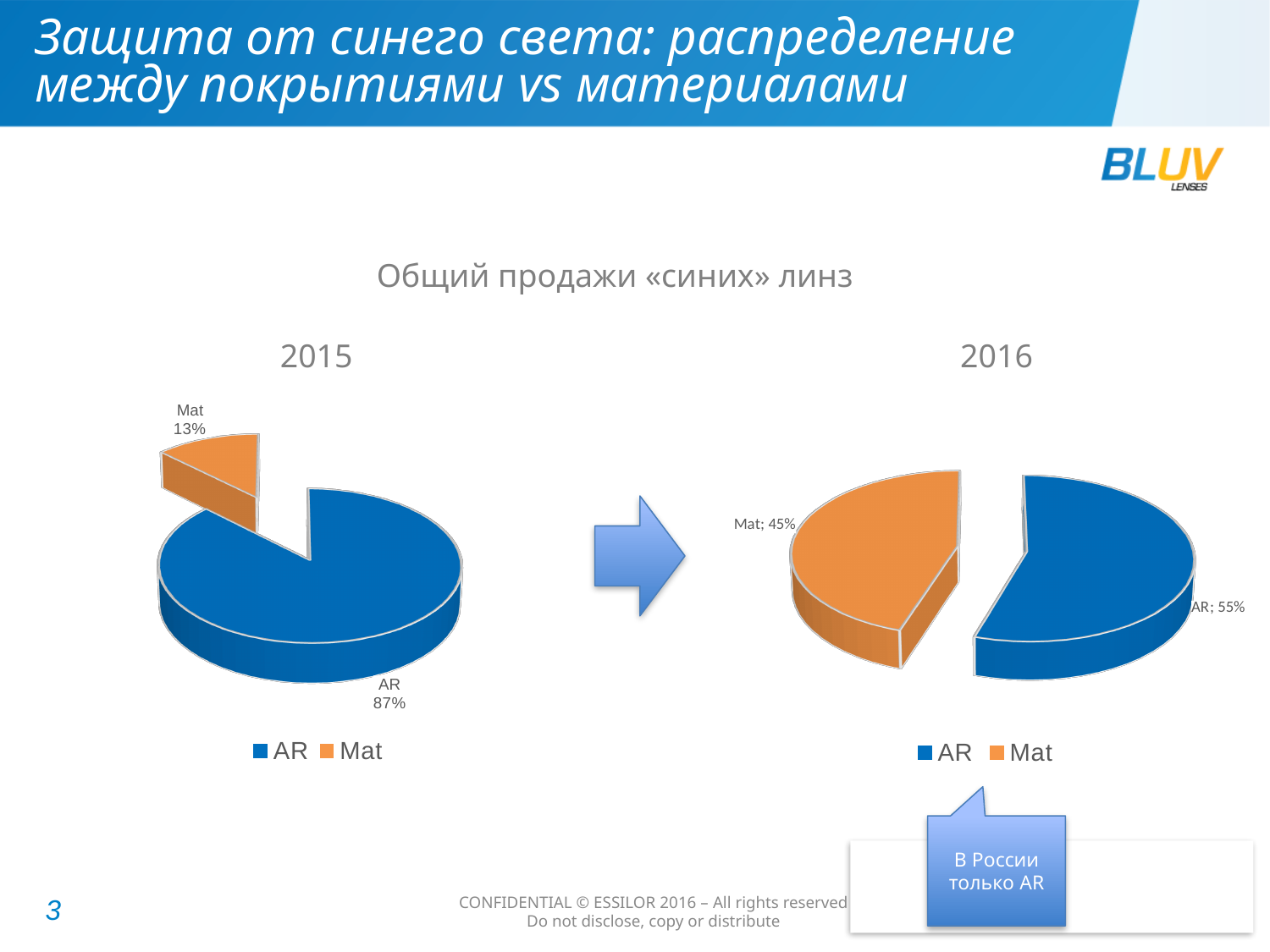
In the 2015 chart, what share does AR have? 87% What kind of chart is the 2015 chart? Pie chart In the 2016 chart, what is the difference between the AR and Mat shares? 10% In the 2015 chart, which category has the largest slice? AR In the 2015 chart, what share does Mat have? 13% In the 2016 chart, what share does AR have? 55% What colour represents Mat in the 2015 chart? Orange In the 2015 chart, what is the difference between the AR and Mat shares? 74% In the 2016 chart, which is larger, AR or Mat? AR How many series does the legend of the 2016 chart list? 2 In the 2016 chart, which category has the smallest slice? Mat